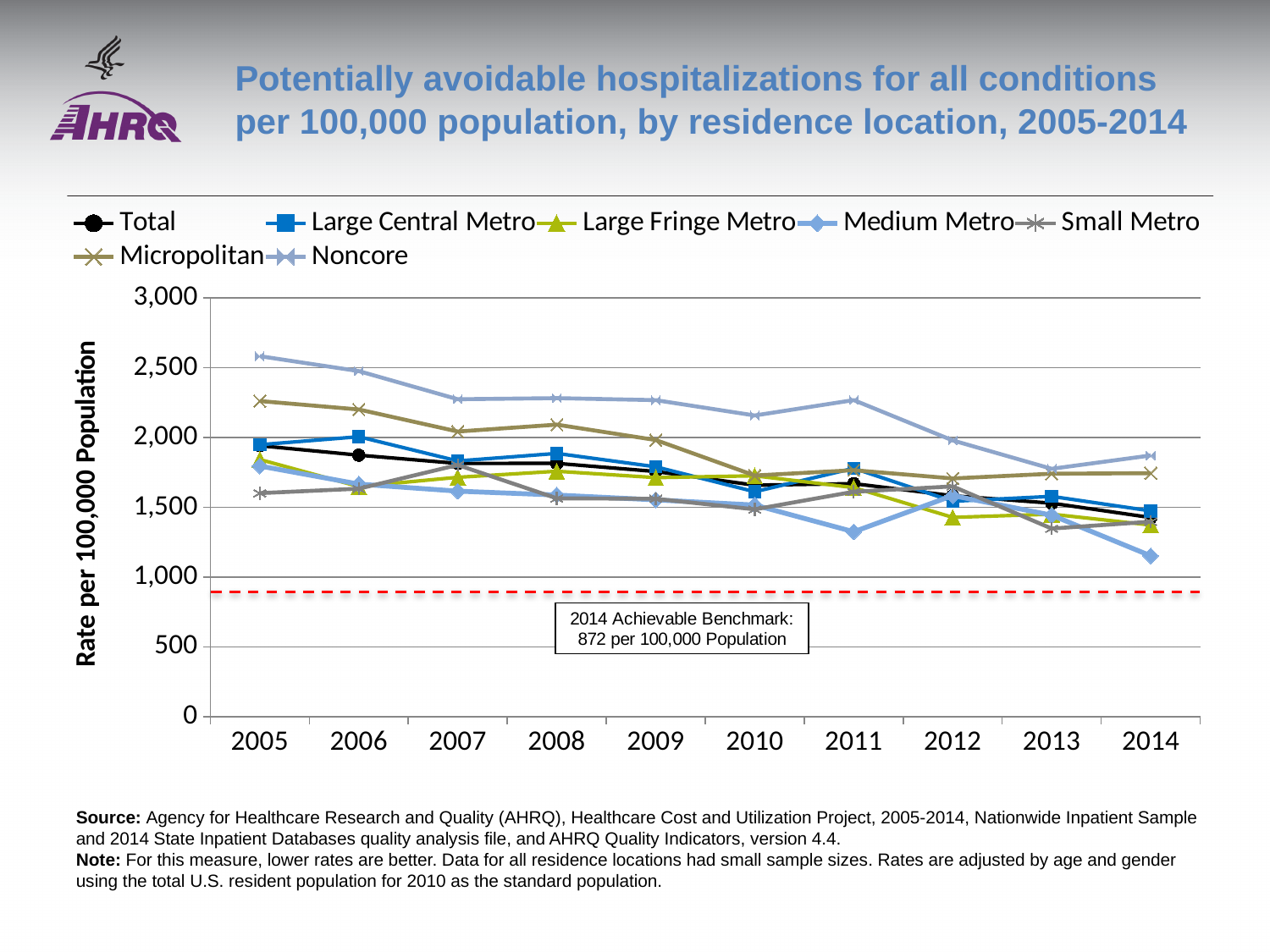
In 2005, which was larger: the Noncore rate or the Micropolitan rate? Noncore Which residence location had the lowest rate in 2014? Medium Metro How many series does the legend list? 7 What kind of chart is shown on the slide? line chart Is the Medium Metro rate in 2014 greater or less than 1,500? less Which residence location had the highest rate in 2014? Noncore Which residence location had the highest rate in 2005? Noncore Does the Noncore rate rise or fall from 2005 to 2014? fall Is the Noncore rate in 2005 greater or less than 2,000? greater Is the Total rate in 2014 greater or less than 1,500? less What is the 2014 achievable benchmark shown on the chart? 872 per 100,000 Population How many years are plotted along the x axis? 10